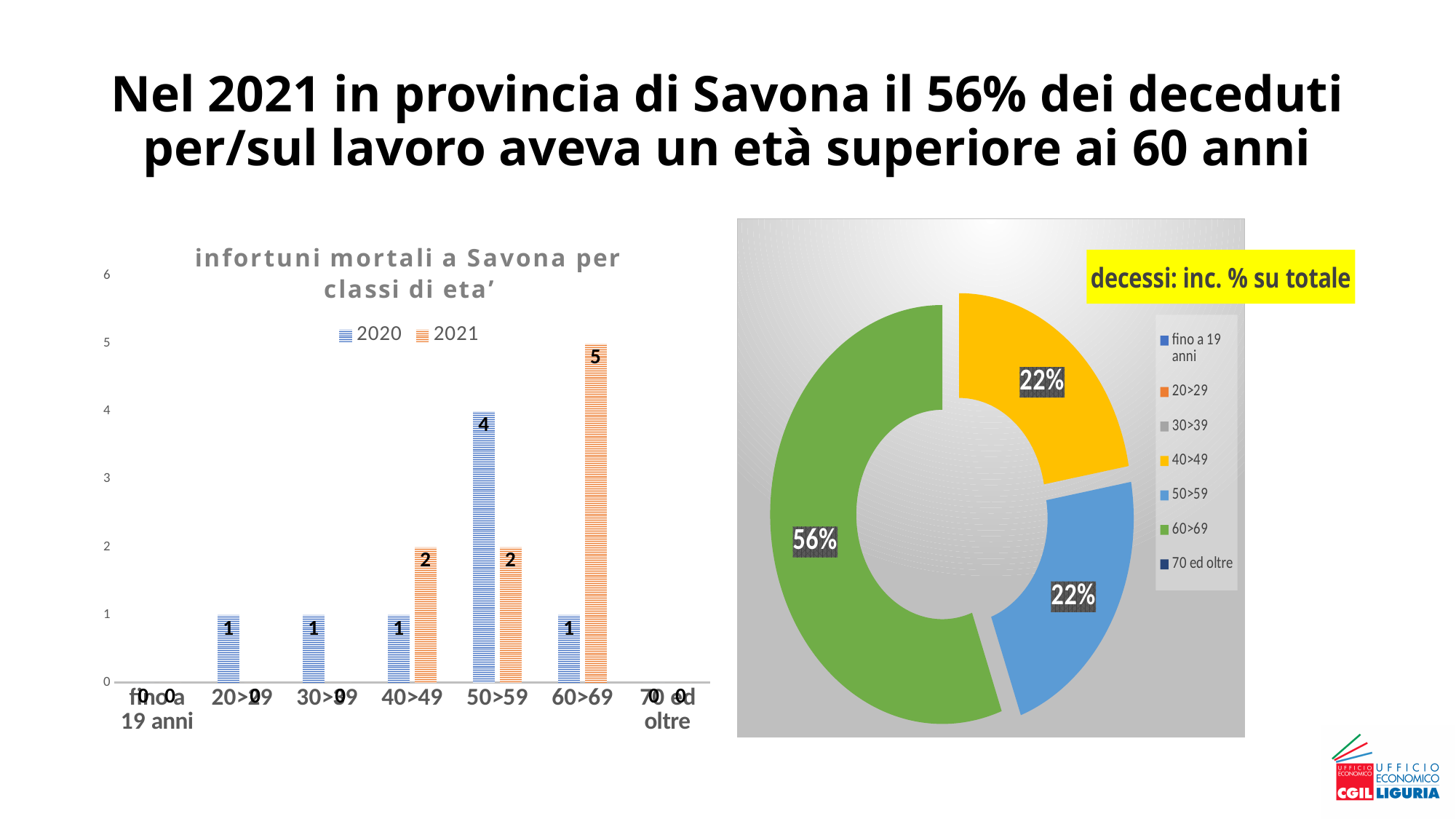
In the doughnut chart 'decessi: inc. % su totale', what share does the 40>49 age class have? 22% In the bar chart 'infortuni mortali a Savona per classi di eta'', what is the 2020 value for the 50>59 age class? 4 In the bar chart 'infortuni mortali a Savona per classi di eta'', which age class has the highest 2020 value? 50>59 In the bar chart 'infortuni mortali a Savona per classi di eta'', which is larger for the 50>59 age class, the 2020 value or the 2021 value? 2020 In the bar chart 'infortuni mortali a Savona per classi di eta'', what is the difference between the 2021 and 2020 values for the 60>69 age class? 4 What kind of chart is the chart on the right titled 'decessi: inc. % su totale'? Doughnut chart In the bar chart 'infortuni mortali a Savona per classi di eta'', what is the 2021 value for the 40>49 age class? 2 In the bar chart 'infortuni mortali a Savona per classi di eta'', what is the 2021 value for the 60>69 age class? 5 How many series does the legend of the bar chart 'infortuni mortali a Savona per classi di eta'' list? 2 In the doughnut chart 'decessi: inc. % su totale', what share does the 60>69 age class have? 56% In the bar chart 'infortuni mortali a Savona per classi di eta'', which age class has the highest 2021 value? 60>69 How many age classes are shown on the x axis of the bar chart 'infortuni mortali a Savona per classi di eta''? 7